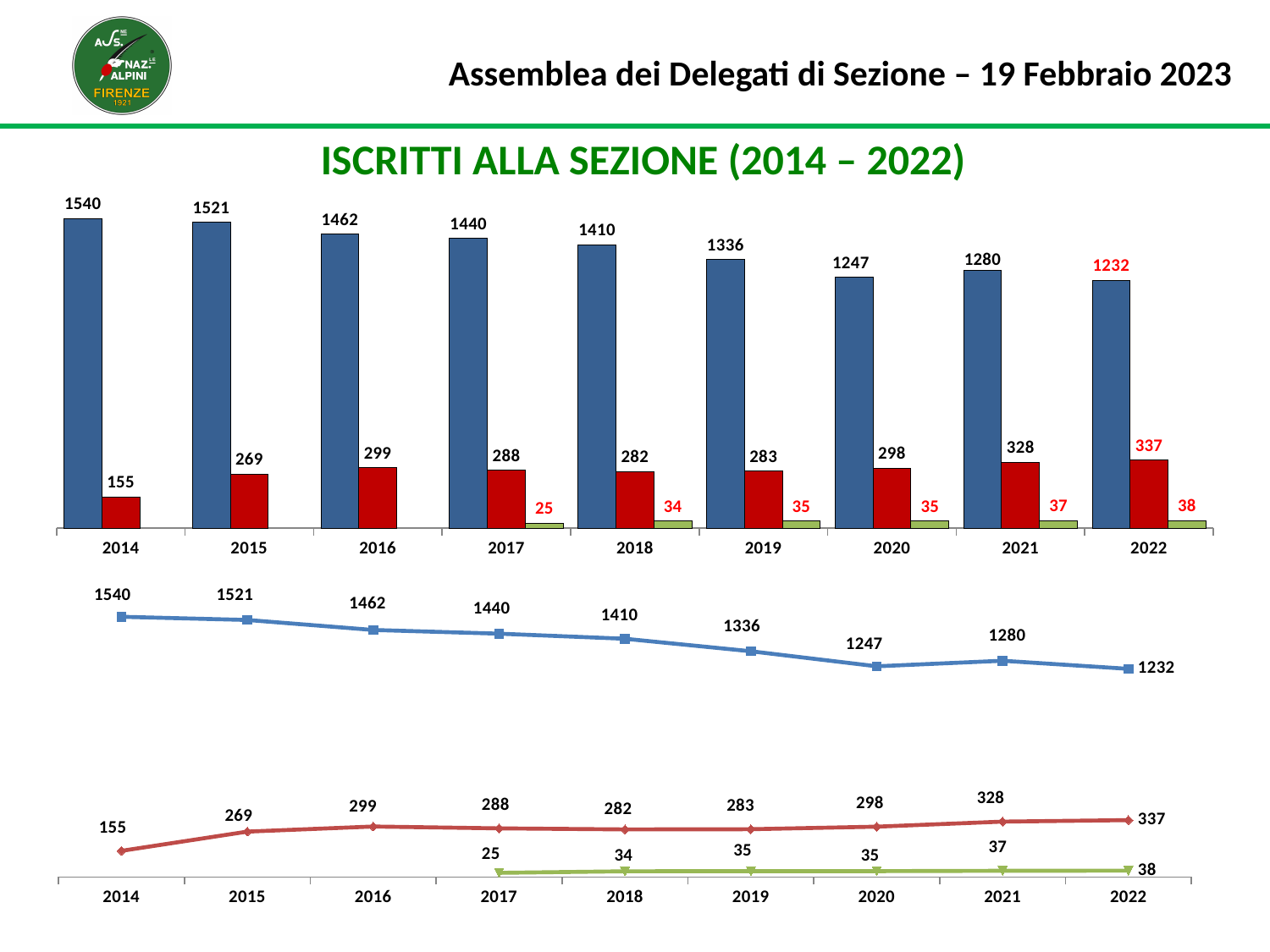
What is the title of the chart on the slide? ISCRITTI ALLA SEZIONE (2014 – 2022) In the line chart, does the blue line generally rise or fall from 2014 to 2022? fall In the bar chart, is the red bar for 2016 larger or smaller than the red bar for 2017? larger What kind of chart is the top chart on the slide? bar chart How many years are shown on the x axis of the bar chart? 9 What kind of chart is the bottom chart on the slide? line chart In the bar chart, what is the difference between the blue bar values for 2014 and 2022? 308 In the bar chart, what is the value of the green bar for 2017? 25 In the bar chart, what is the value of the blue bar for 2014? 1540 In the bar chart, which year has the lowest blue bar? 2022 In the bar chart, which year has the highest red bar? 2022 In the bar chart, what is the value of the red bar for 2021? 328